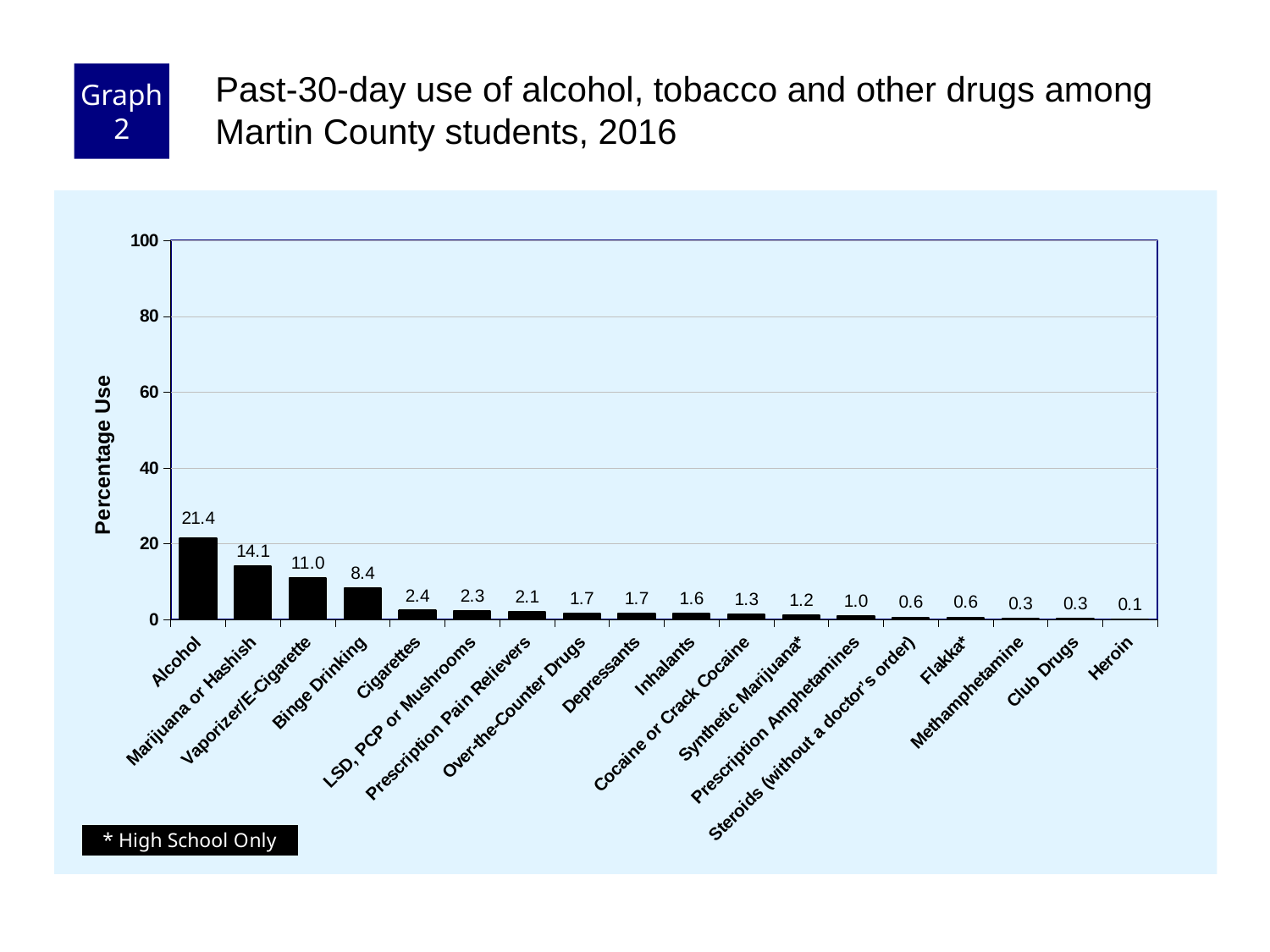
What is the value shown for Heroin? 0.1 What is the difference between the values for Alcohol and Marijuana or Hashish? 7.3 What is the past-30-day use percentage for Alcohol? 21.4 What kind of chart is shown on the slide? Bar chart What is the label of the y axis? Percentage Use Which category has the lowest past-30-day use? Heroin What is the value shown for Binge Drinking? 8.4 What is the value shown for Vaporizer/E-Cigarette? 11.0 Which is larger, the value for Cigarettes or the value for Binge Drinking? Binge Drinking How many categories are shown on the x axis? 18 Which category has the highest past-30-day use? Alcohol Is the value for Alcohol greater or less than 20? greater